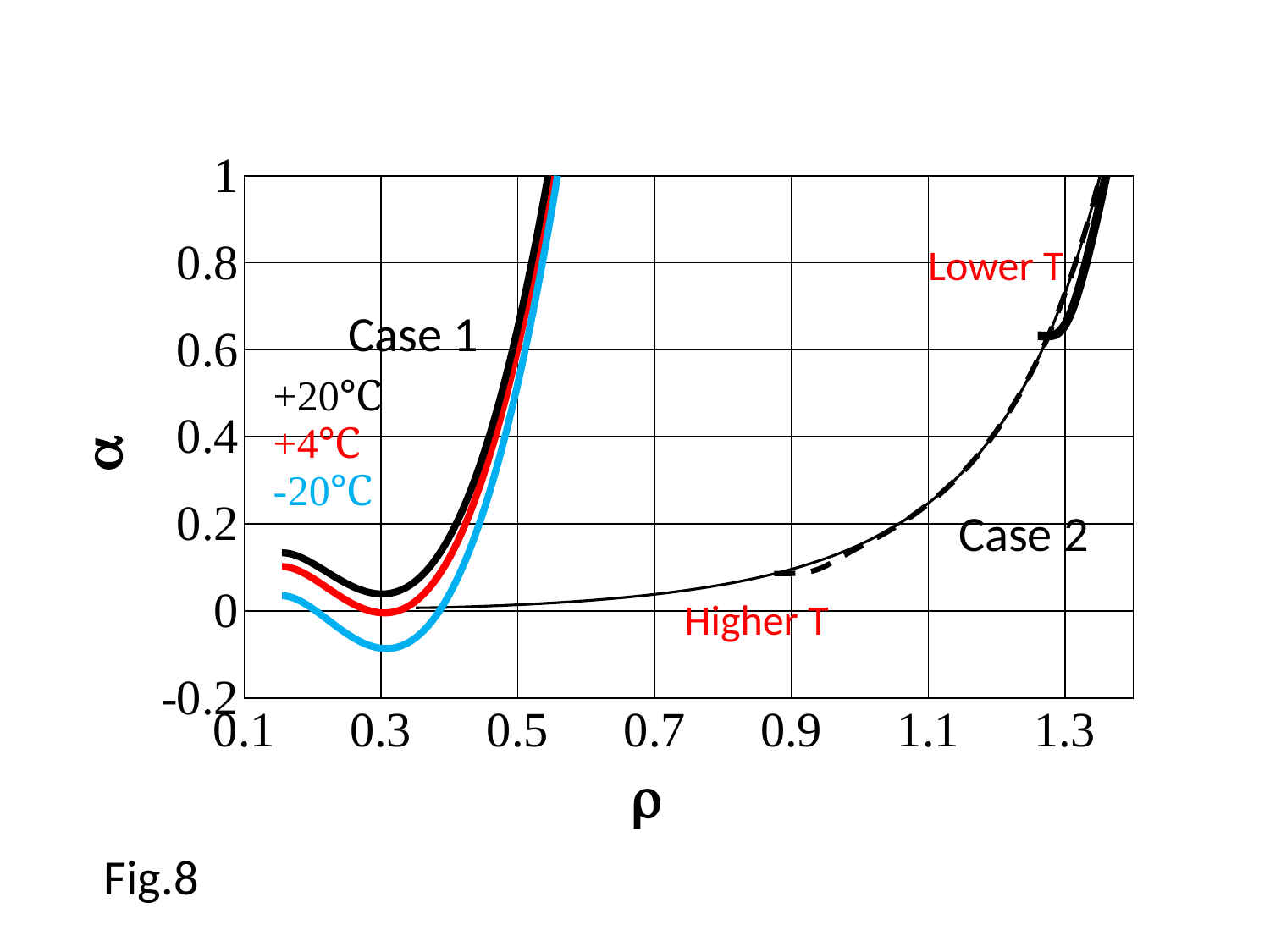
At ρ = 0.3, which Case 1 curve has the higher α: +20°C or -20°C? +20°C At ρ = 0.3, which Case 1 curve has the lowest α? -20°C Is the value of α for the -20°C curve at ρ = 0.3 greater or less than 0? less Is the value of α for the +20°C curve at ρ = 0.3 greater or less than 0.2? less Which colour is used for the -20°C curve in Case 1? blue Does α for the Case 2 curve rise or fall as ρ increases from 0.5 to 1.3? rise Is the value of α for the Case 2 curve at ρ = 1.1 greater or less than 0.2? greater How many temperature curves are plotted for Case 1? 3 What kind of chart is shown on the slide? line chart What is the label of the y axis? α What is the label of the x axis? ρ